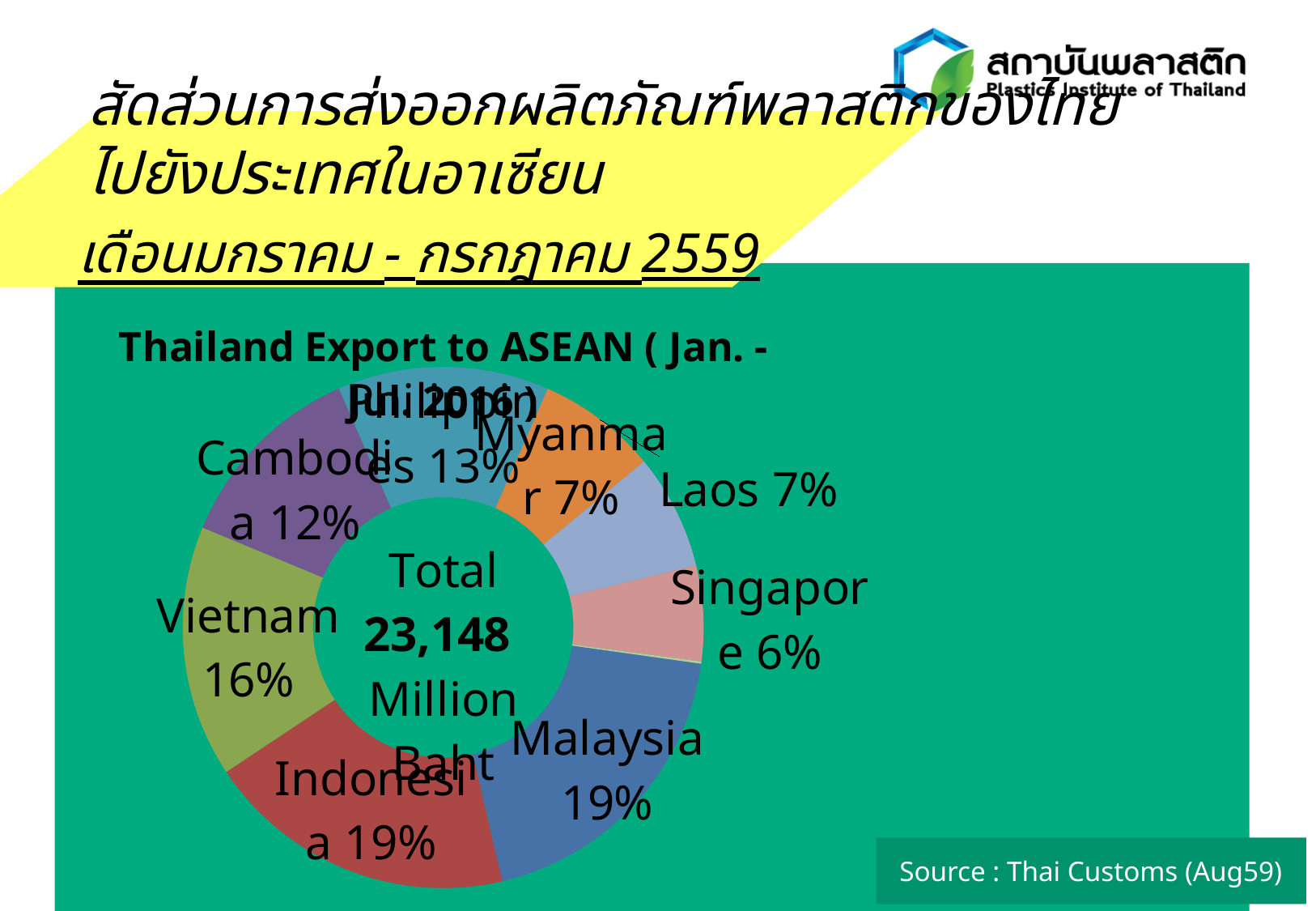
What is the source cited for the chart data? Thai Customs (Aug59) What share of Thailand's exports to ASEAN goes to Vietnam? 16% Which has a larger share, Vietnam or the Philippines? Vietnam What share of Thailand's exports to ASEAN goes to Malaysia? 19% What share of Thailand's exports to ASEAN goes to the Philippines? 13% What is the total value of Thailand's exports to ASEAN shown in the centre of the chart? 23,148 Million Baht What share of Thailand's exports to ASEAN goes to Singapore? 6% What is the difference in percentage points between Vietnam's share and Cambodia's share? 4 What kind of chart is shown on the slide? Doughnut (pie) chart What share of Thailand's exports to ASEAN goes to Cambodia? 12%